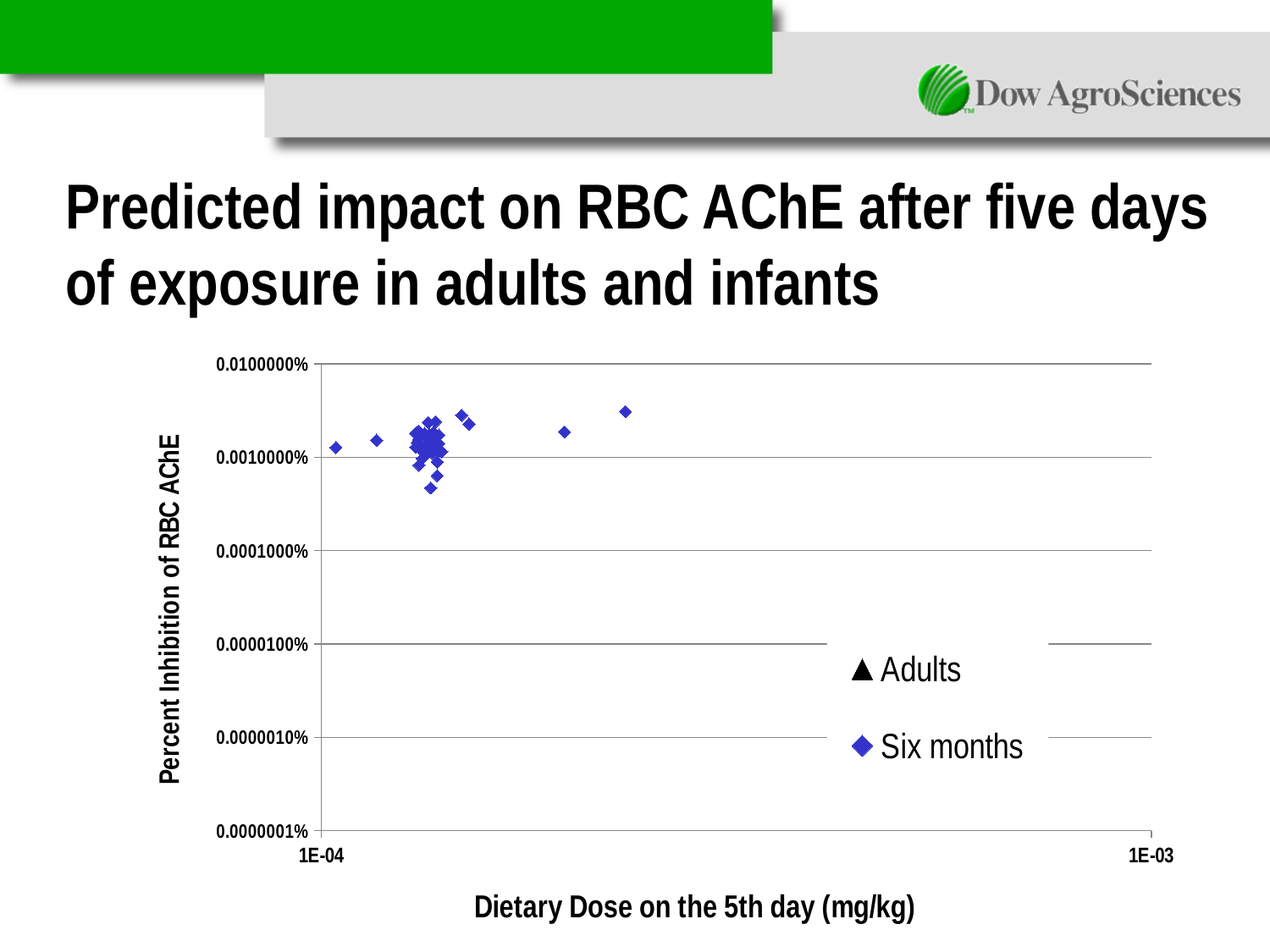
What kind of chart is shown on the slide? scatter chart Do the plotted Six months values generally rise or fall as dietary dose increases along the x axis? rise Which series in the legend is shown with a diamond marker? Six months What are the two series named in the chart legend? Adults and Six months Is the Six months point at the far left of the chart (near 1E-04 mg/kg) greater or less than 0.0001000% inhibition? greater Is the Six months point at the far right of the chart greater or less than 0.0010000% inhibition? greater Are the plotted Six months values greater or less than 0.0100000% inhibition? less What is the title of the chart's x axis? Dietary Dose on the 5th day (mg/kg) How many series does the chart legend list? 2